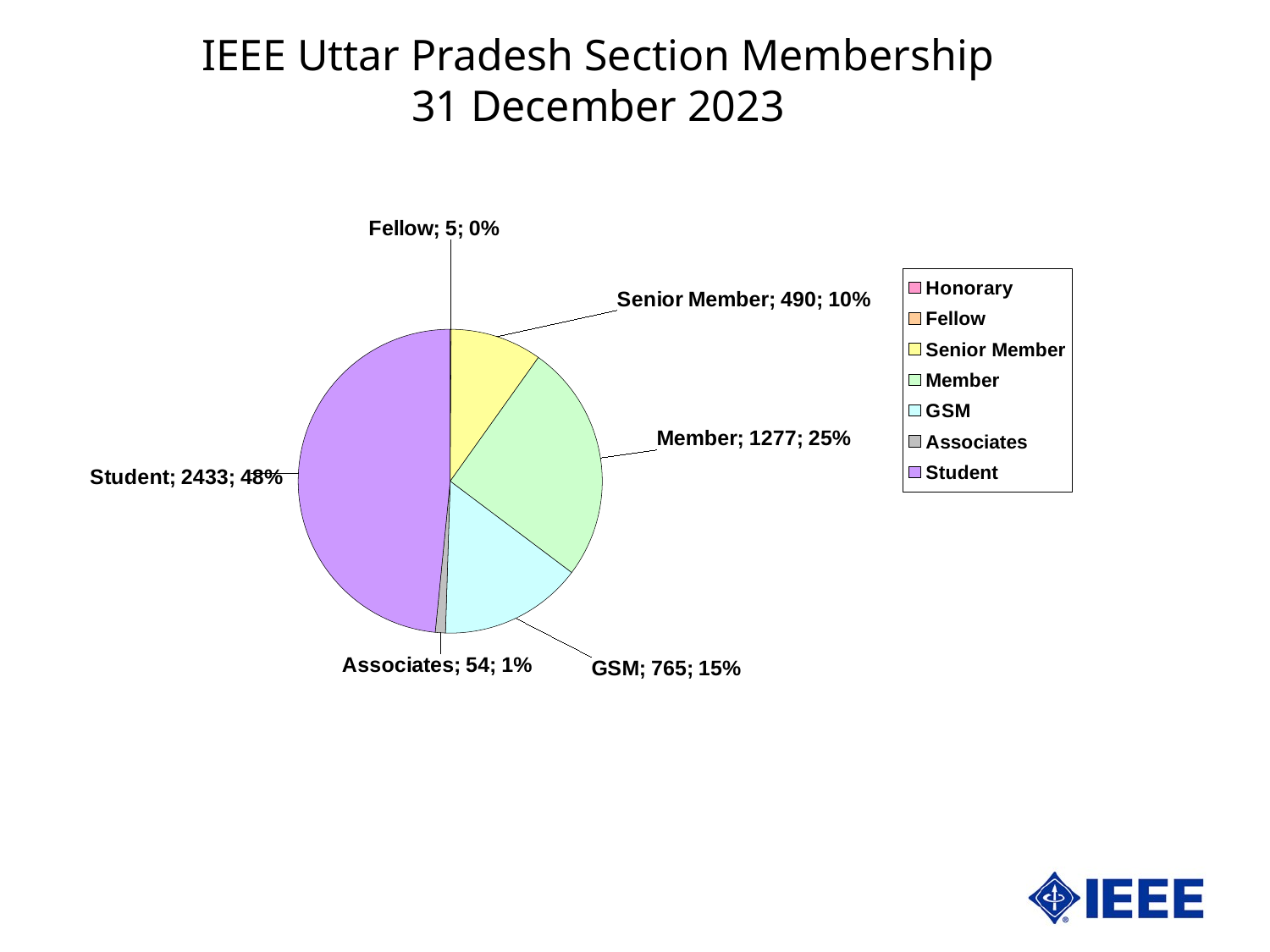
Which labelled category has the smallest slice of the pie? Fellow What is the title of the chart? IEEE Uttar Pradesh Section Membership 31 December 2023 Which is larger, the GSM count or the Senior Member count? GSM How many members does the Student slice represent? 2433 What share of the pie does the Associates slice represent? 1% Which category has the largest slice of the pie? Student What share of the pie does the Senior Member slice represent? 10% What share of the pie does the Member slice represent? 25% What is the difference between the Member count and the Senior Member count? 787 How many members does the GSM slice represent? 765 How many entries does the legend list? 7 What kind of chart is shown on the slide? pie chart